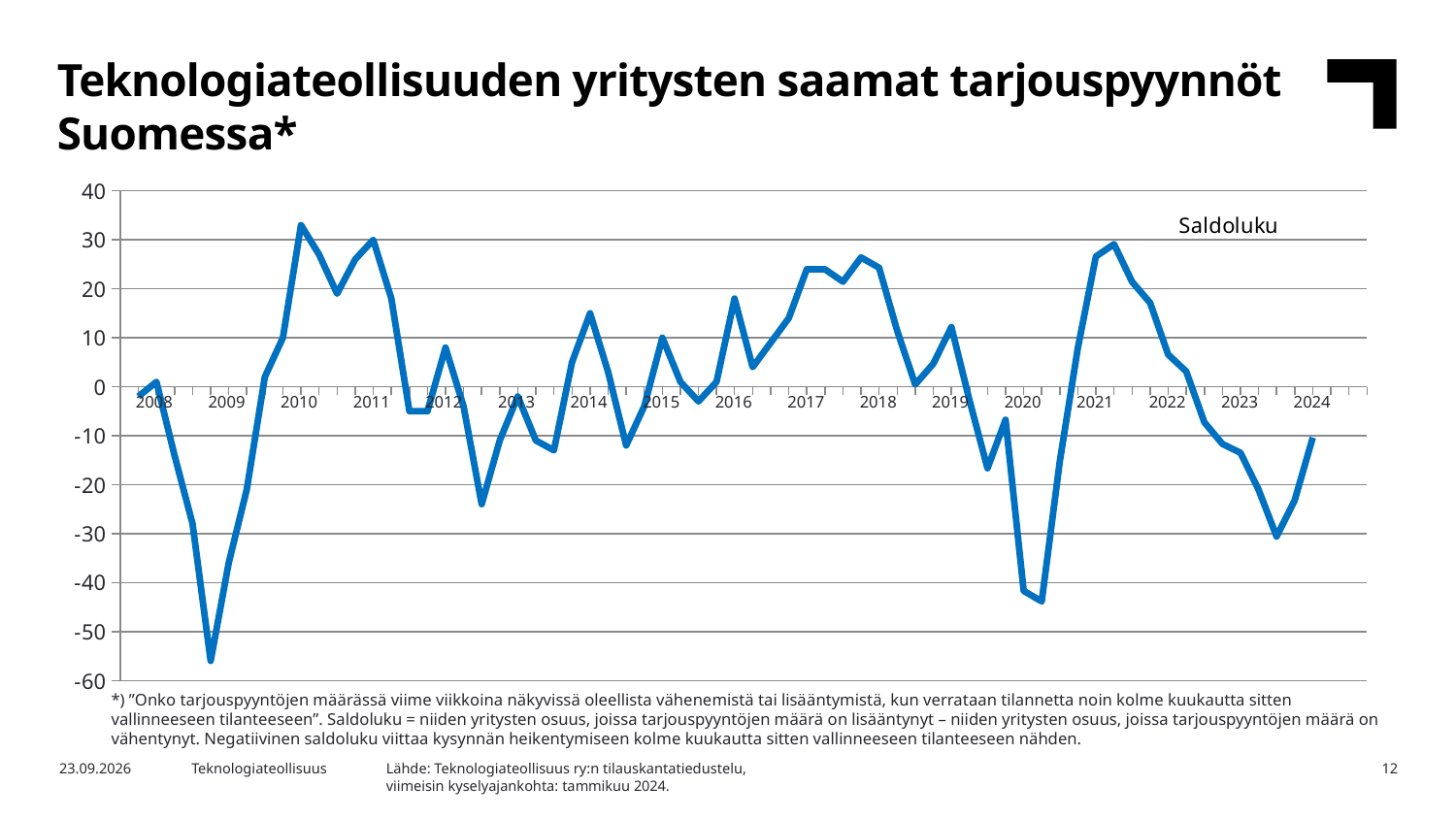
Is the lowest value of the line, reached in 2009, greater or less than -50? less Does the line rise or fall between 2008 and early 2009? fall Is the trough value of the line in 2020 greater or less than -40? less In which year does the line reach its lowest value? 2009 What is the title of the chart on the slide? Saldoluku What is the name of the series shown in the chart? Saldoluku What kind of chart is shown on the slide? line chart Is the last plotted value of the line, in 2024, greater or less than 0? less Does the line rise or fall between 2020 and 2021? rise